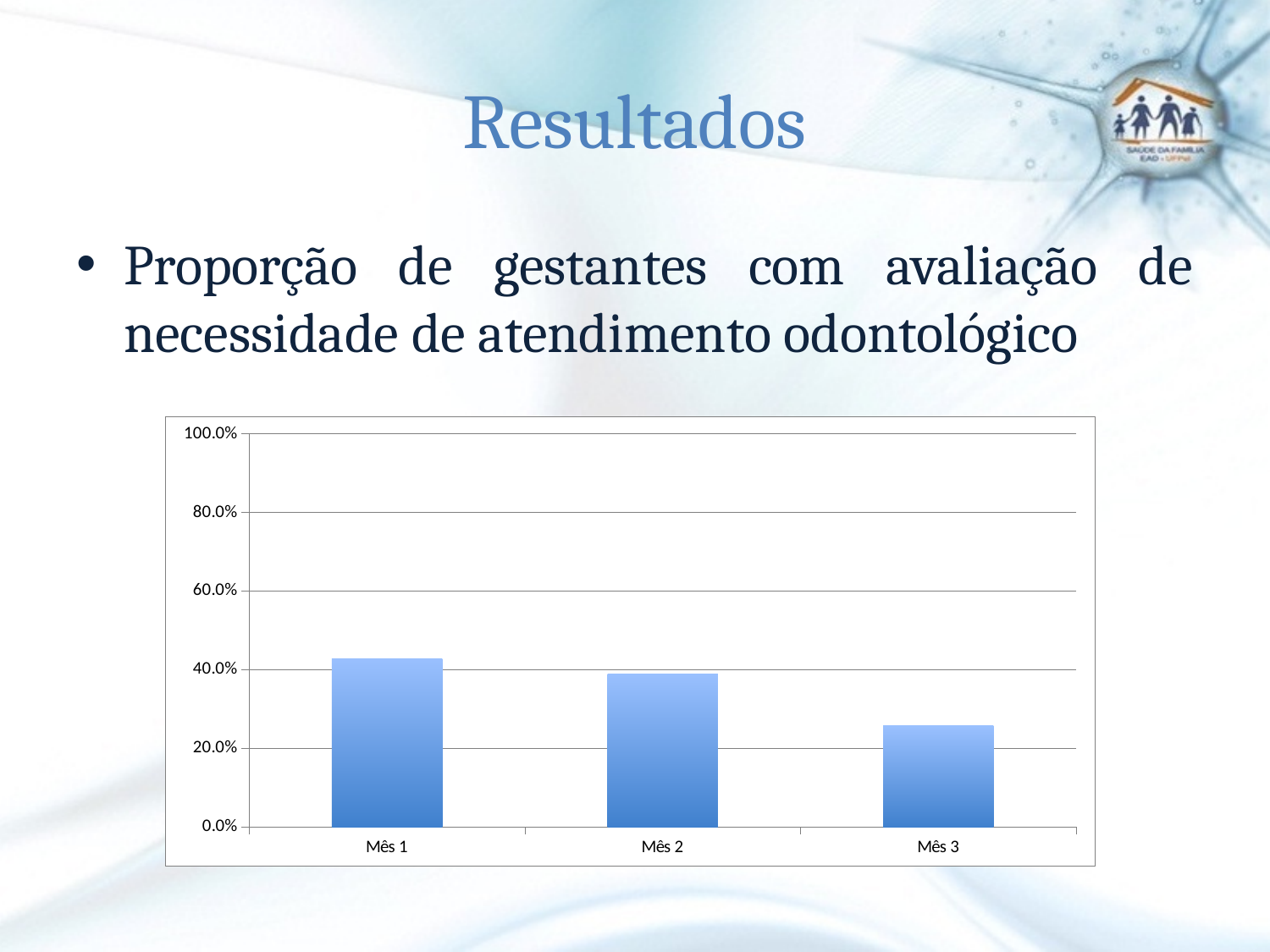
Which is larger, the value for Mês 2 or the value for Mês 3? Mês 2 Is the value for Mês 2 greater or less than 60.0%? less Which month has the lowest value on the chart? Mês 3 Is the value for Mês 2 greater or less than 20.0%? greater Is the value for Mês 3 greater or less than 40.0%? less What kind of chart is shown on the slide? bar chart What is the highest value shown on the vertical axis of the chart? 100.0% Which month has the highest value on the chart? Mês 1 How many categories (months) are plotted on the chart? 3 Do the values rise or fall from Mês 1 to Mês 3? fall